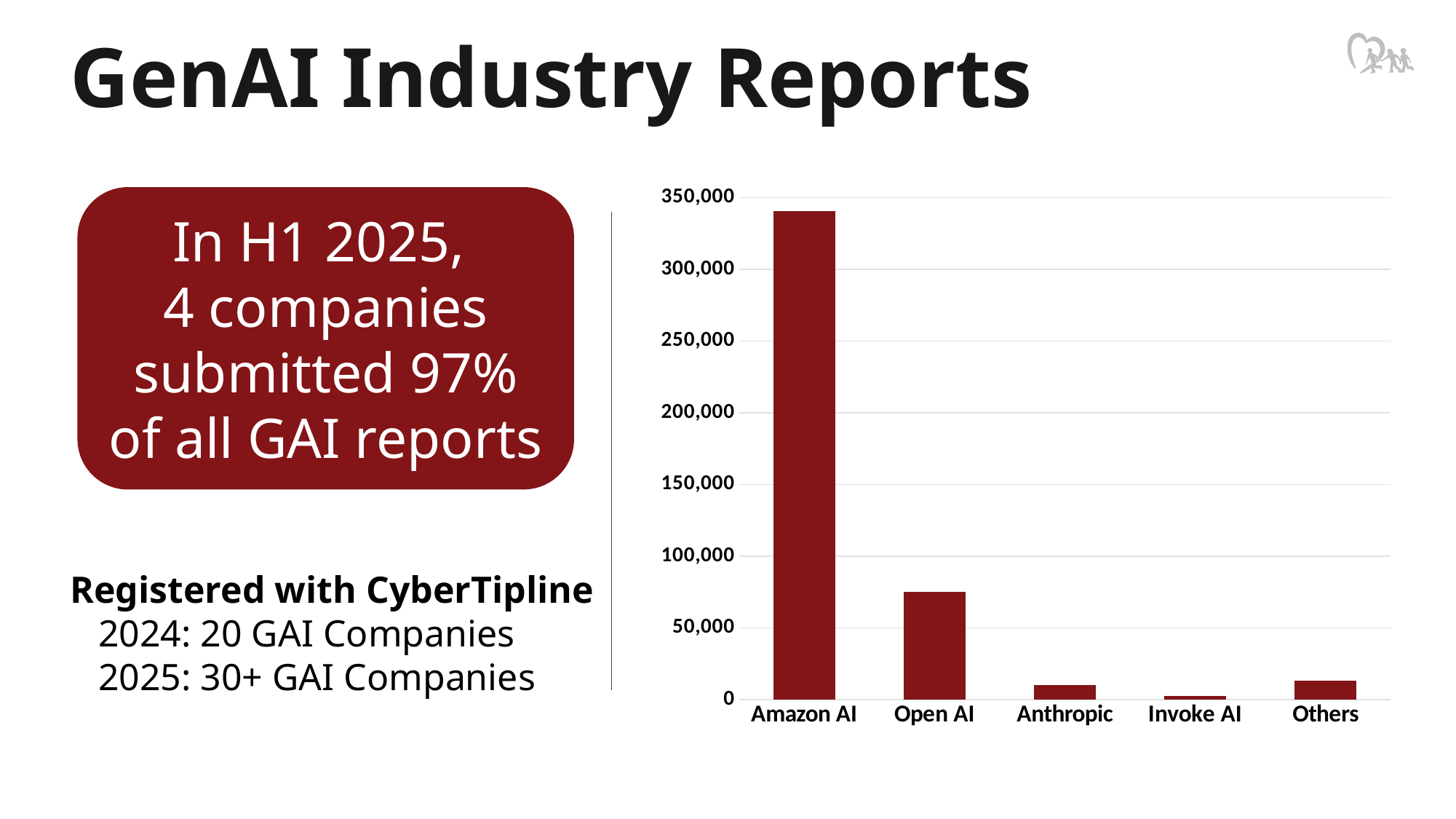
Is the value for Open AI greater or less than 50,000? greater Which category has the highest bar in the chart? Amazon AI Is the value for Anthropic greater or less than 50,000? less What kind of chart is shown on the slide? bar chart Which category has the lowest bar in the chart? Invoke AI Is the value for Open AI greater or less than 100,000? less What is the highest value labelled on the chart's vertical axis? 350,000 How many categories are shown on the x axis of the chart? 5 Which is larger, the value for Open AI or the value for Anthropic? Open AI Which is larger, the value for Amazon AI or the value for Open AI? Amazon AI